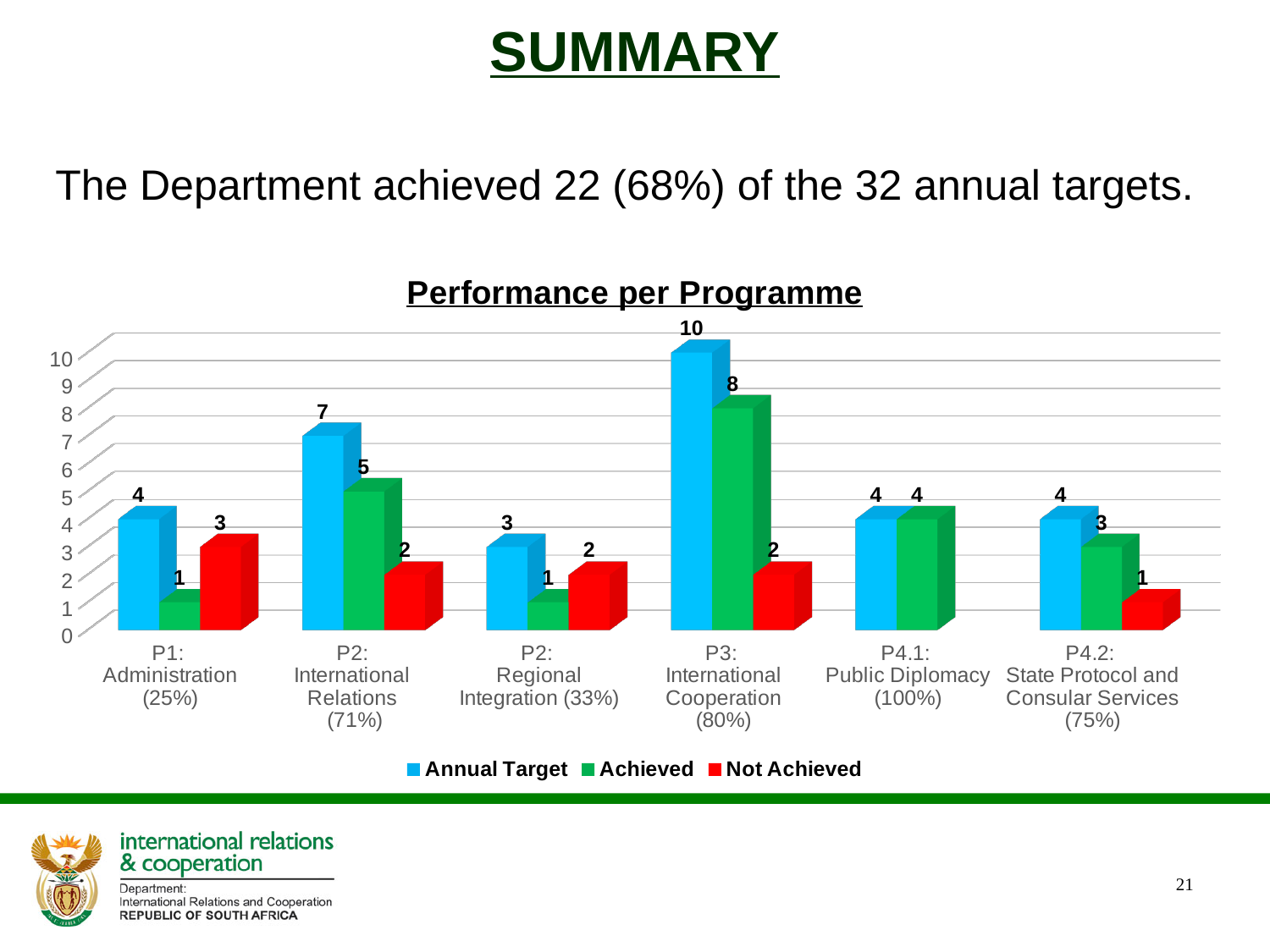
What is the difference between the Annual Target and Achieved values for P3: International Cooperation? 2 How many series does the legend list? 3 What is the title of the chart? Performance per Programme Which programme has the lowest Annual Target? P2: Regional Integration Which colour represents the Achieved series in the chart? Green Which is larger for P1: Administration, the Achieved value or the Not Achieved value? Not Achieved How many programme categories are shown on the x axis? 6 What kind of chart is shown on the slide? Bar chart What is the Not Achieved value for P1: Administration? 3 How many targets were Achieved for P2: International Relations? 5 Which programme has the highest Annual Target? P3: International Cooperation What is the Annual Target value for P3: International Cooperation? 10